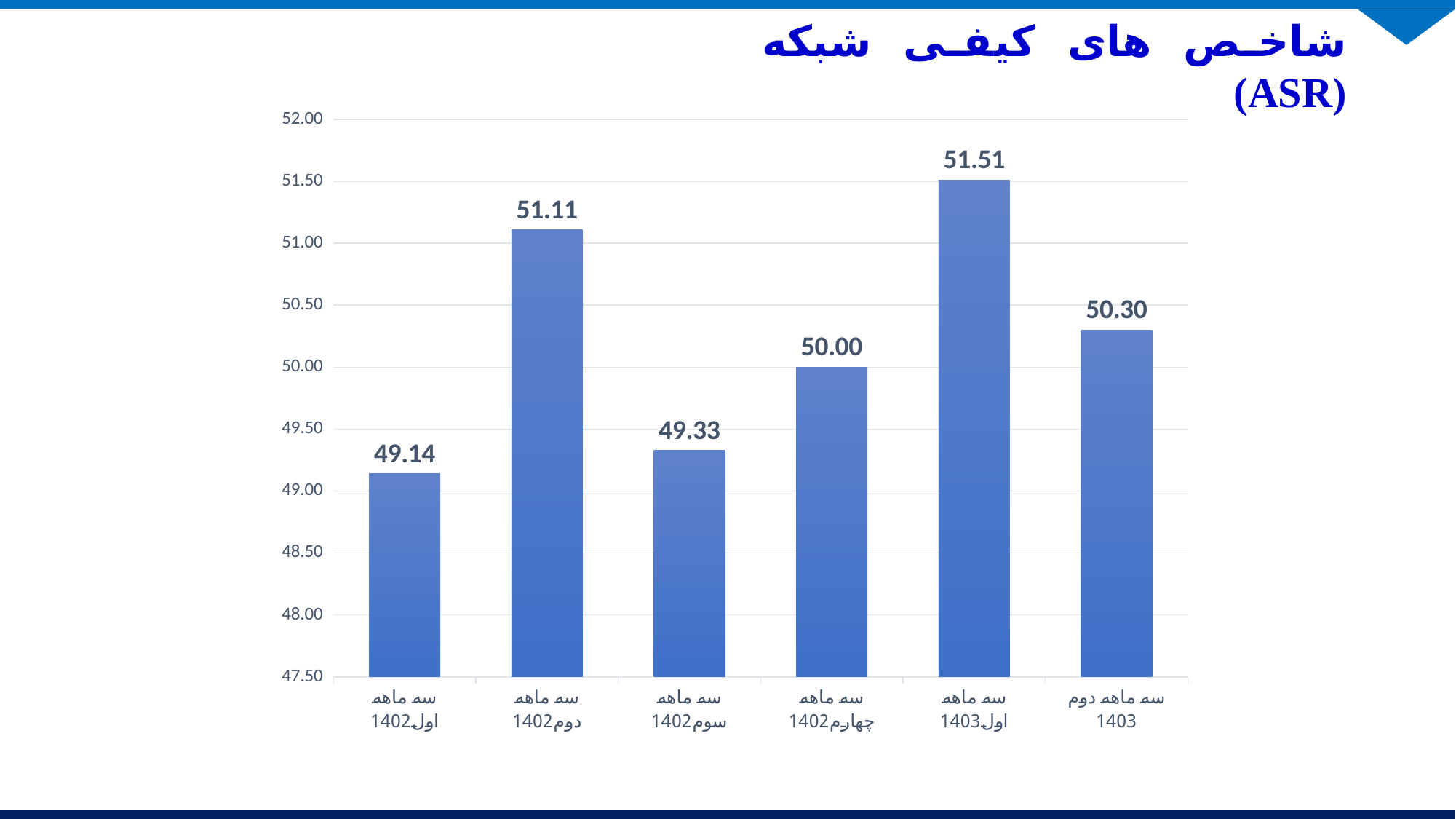
What kind of chart is shown on the slide? bar chart What is the value for سه ماهه دوم 1403 (Q2 1403)? 50.30 What is the difference between the values for سه ماهه اول 1403 and سه ماهه اول 1402? 2.37 Is the value for سه ماهه دوم 1402 greater or less than 51.00? greater How many periods (bars) are shown in the chart? 6 Which is larger, the value for سه ماهه سوم 1402 or سه ماهه چهارم 1402? سه ماهه چهارم 1402 What is the value for سه ماهه چهارم 1402 (Q4 1402)? 50.00 Which period has the highest value? سه ماهه اول 1403 Which period has the lowest value? سه ماهه اول 1402 What is the value for سه ماهه اول 1402 (Q1 1402)? 49.14 What indicator is named in parentheses in the slide title? ASR What is the value for سه ماهه دوم 1402 (Q2 1402)? 51.11